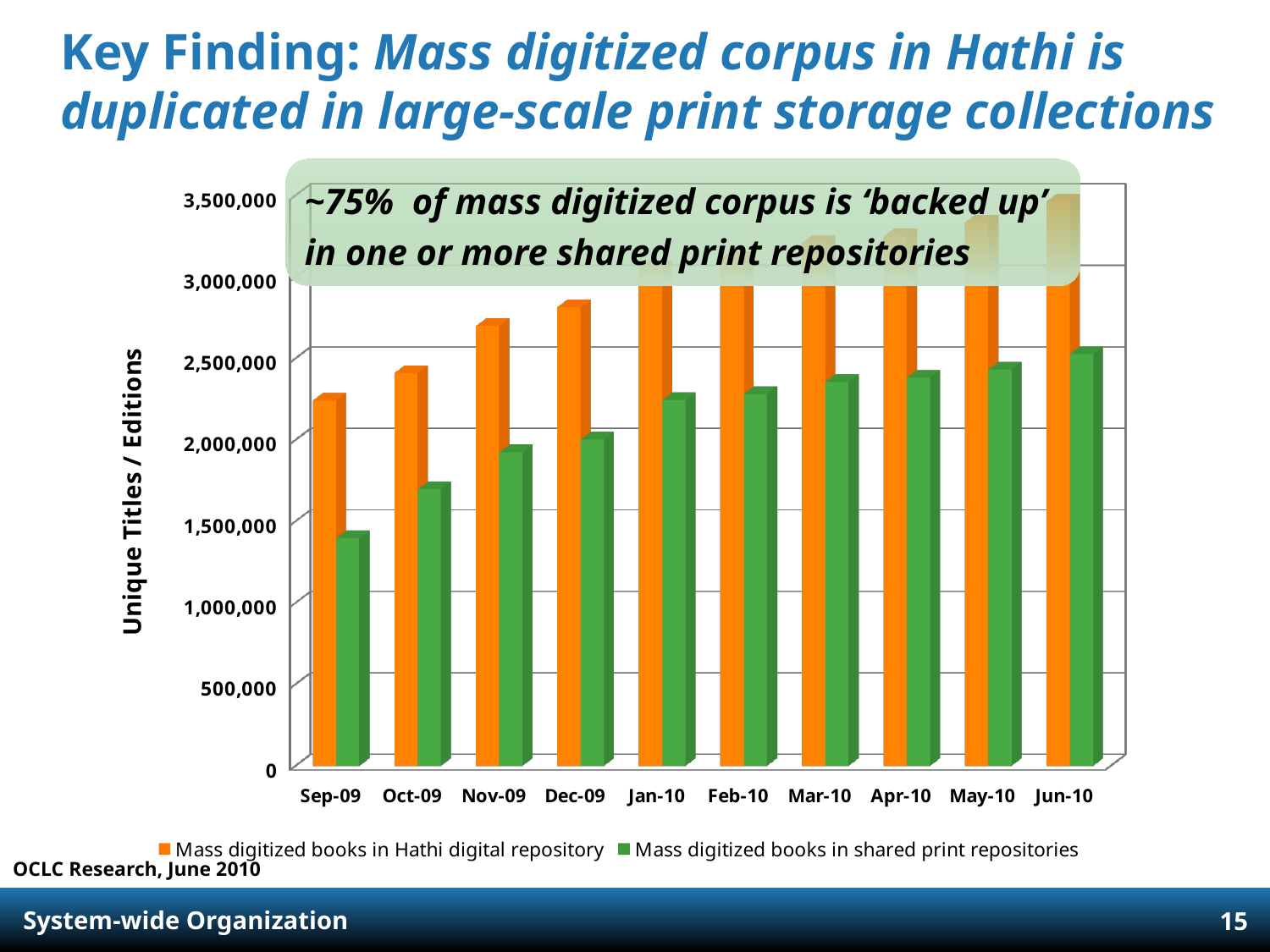
Which series is shown in green? Mass digitized books in shared print repositories Which month has the highest value for Mass digitized books in Hathi digital repository? Jun-10 What kind of chart is shown on the slide? bar chart How many months are shown along the x axis? 10 Is the value for Mass digitized books in Hathi digital repository in Mar-10 greater or less than 3,000,000? greater What is the label on the vertical axis? Unique Titles / Editions How many series does the legend list? 2 In Sep-09, which is larger: Mass digitized books in Hathi digital repository or Mass digitized books in shared print repositories? Mass digitized books in Hathi digital repository Do the values for Mass digitized books in shared print repositories rise or fall from Sep-09 to Jun-10? rise Which month has the lowest value for Mass digitized books in shared print repositories? Sep-09 Is the value for Mass digitized books in Hathi digital repository in Nov-09 greater or less than 2,500,000? greater Is the value for Mass digitized books in shared print repositories in Sep-09 greater or less than 1,500,000? less